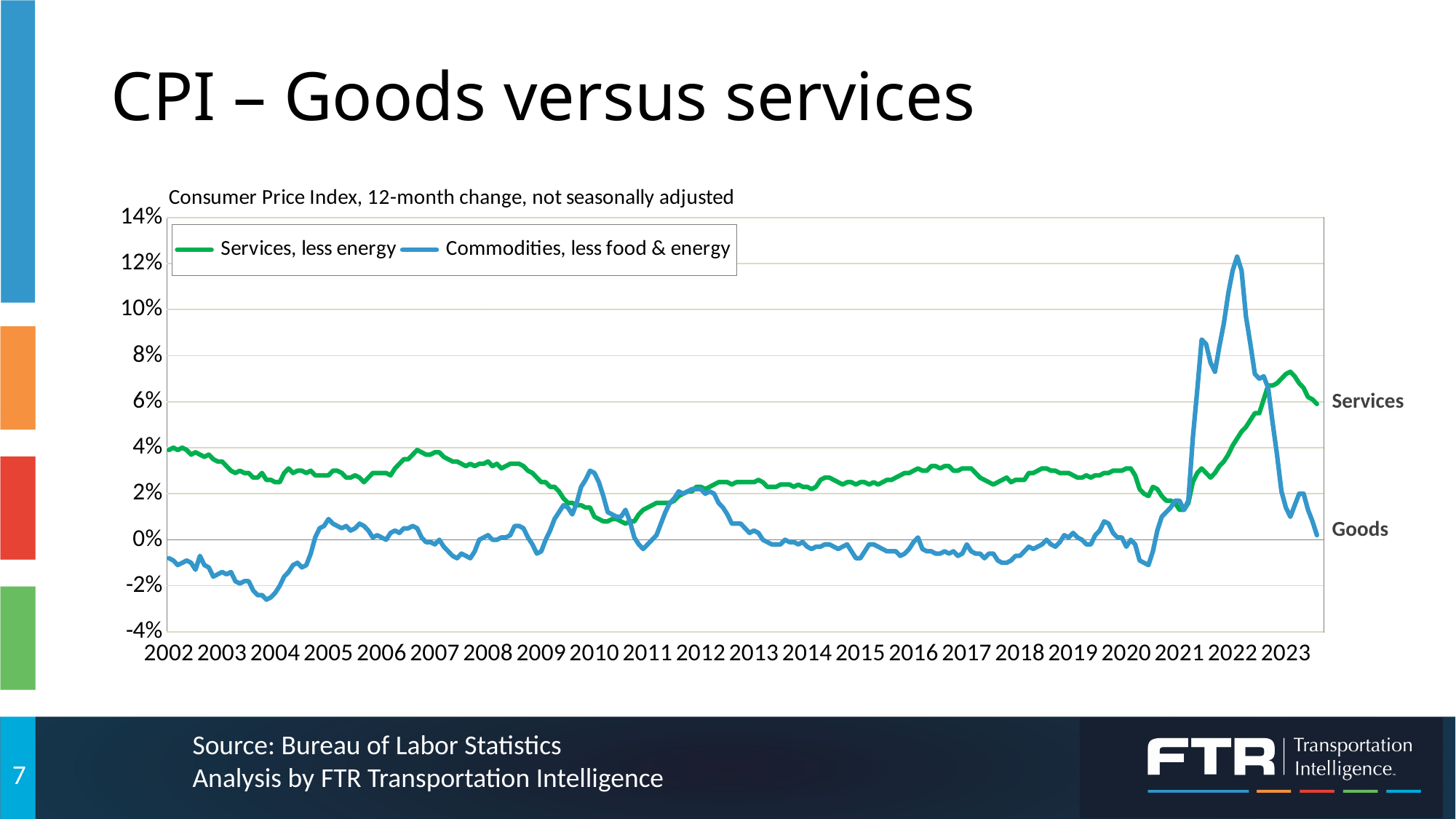
How many series does the legend list? 2 Which series reaches the higher peak value over the whole period? Commodities, less food & energy What is the title printed above the chart? Consumer Price Index, 12-month change, not seasonally adjusted Is the peak value of the Services, less energy line greater or less than 6%? greater Is the value of the Services, less energy line at the start of 2002 greater or less than 2%? greater What kind of chart is shown on the slide? Line chart At the right end of the chart in 2023, which series is higher, Services or Goods? Services Is the lowest value of the Commodities, less food & energy line greater or less than -2%? less How many year labels are shown on the x axis? 22 After its 2022 peak, does the Commodities, less food & energy line rise or fall through 2023? fall What colour is the line for Services, less energy? Green